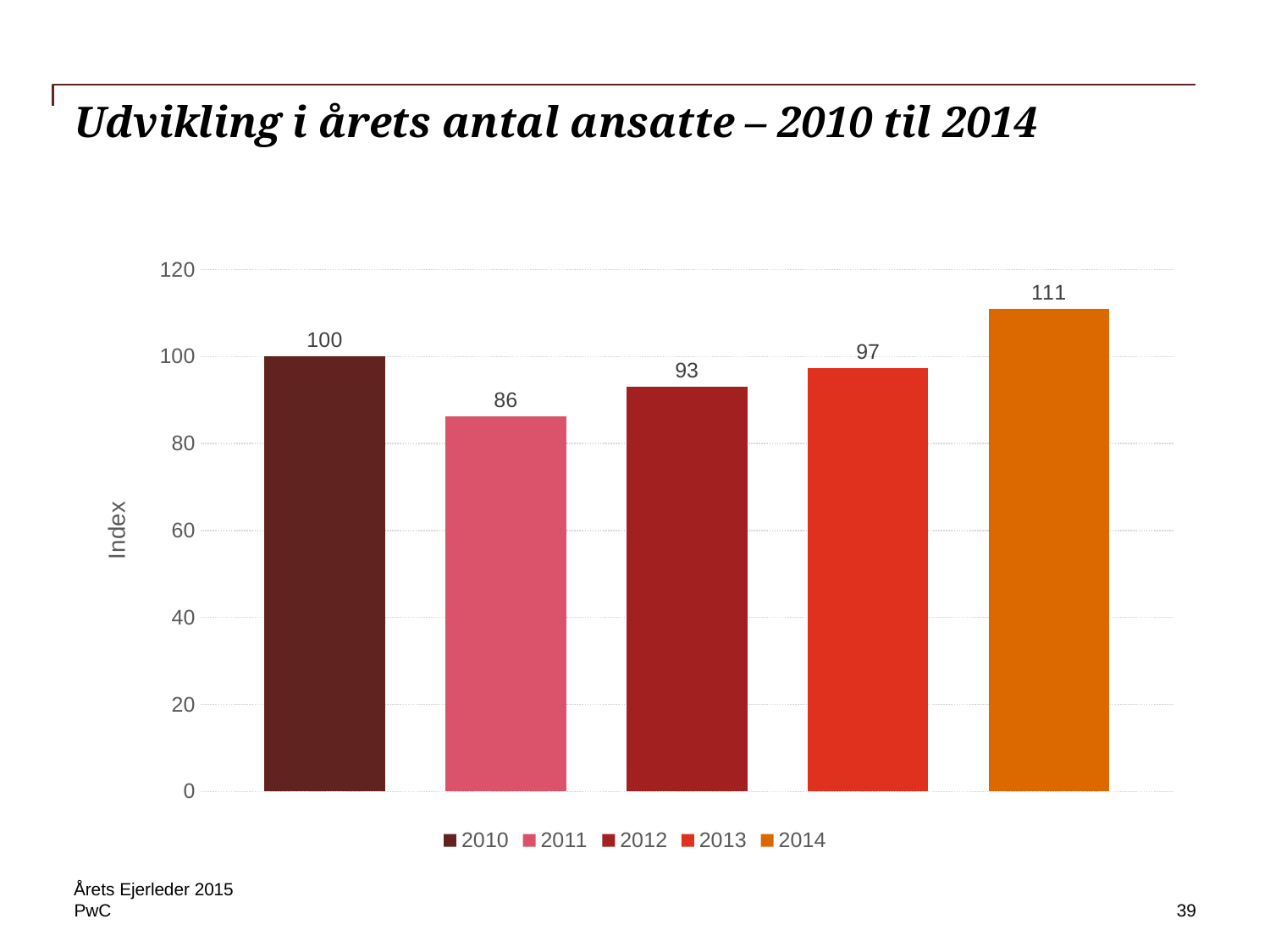
What is the label on the vertical axis? Index What is the index value for 2014? 111 Which has a higher index value, 2012 or 2013? 2013 What is the index value for 2011? 86 Is the value for 2013 greater or less than 100? less How many years are shown in the chart? 5 What kind of chart is shown on the slide? Bar chart Which year has the highest index value? 2014 Which year has the lowest index value? 2011 What is the index value for 2010? 100 How many entries does the legend list? 5 What is the difference between the index values for 2014 and 2011? 25